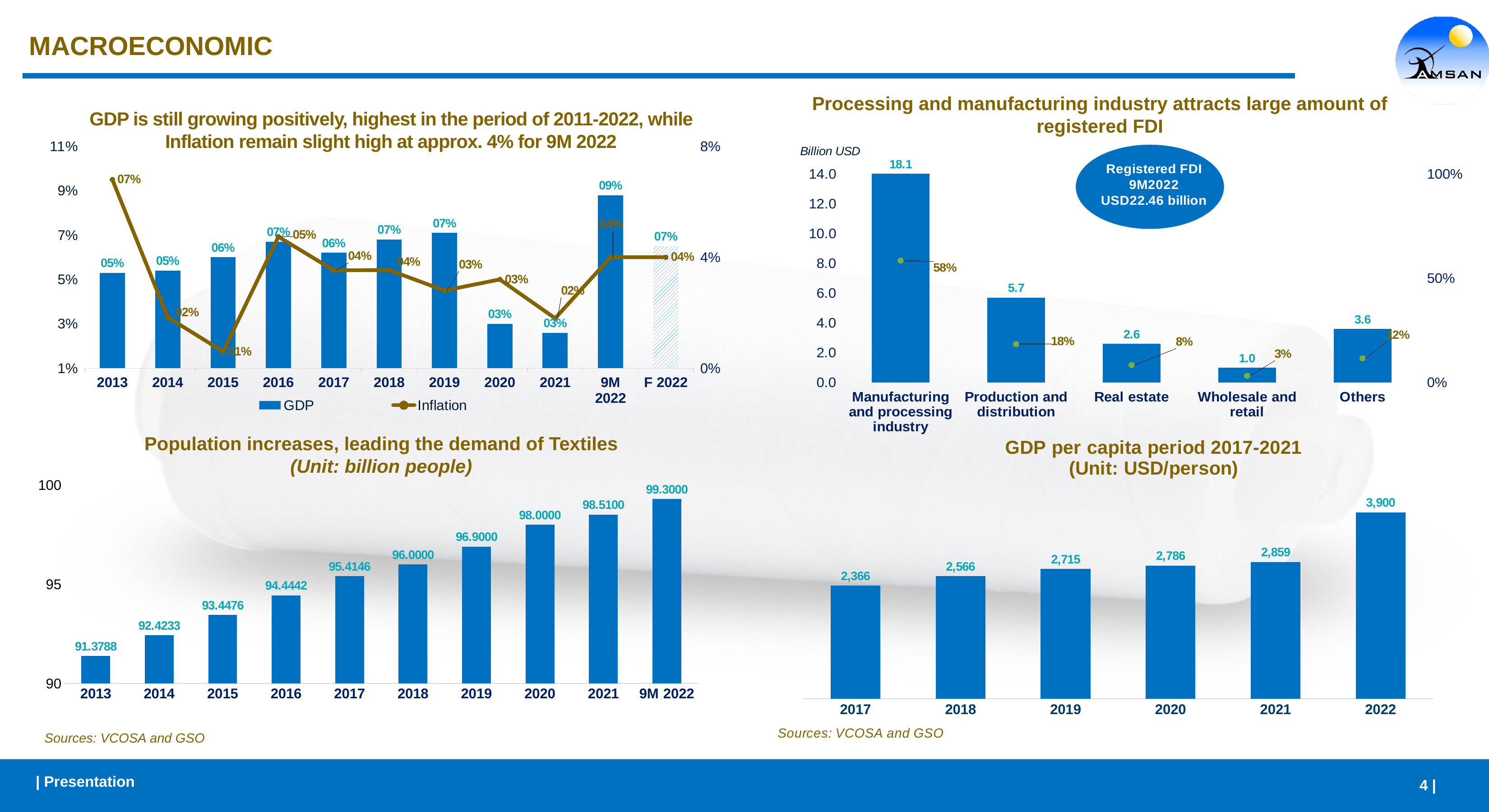
In the top-left GDP and Inflation chart, what is the GDP value for 9M 2022? 09% In the 'Population increases, leading the demand of Textiles' chart, how many bars are plotted? 10 In the 'GDP per capita period 2017-2021' chart, which year has the highest value? 2022 In the 'Population increases, leading the demand of Textiles' chart, what is the value for 2016? 94.4442 In the 'Processing and manufacturing industry attracts large amount of registered FDI' chart, which category has the lowest value? Wholesale and retail In the 'Processing and manufacturing industry attracts large amount of registered FDI' chart, what percentage share is shown for Others? 12% In the top-left GDP and Inflation chart, what is the Inflation value for 2015? 01% In the 'Population increases, leading the demand of Textiles' chart, do the values rise or fall from 2013 to 9M 2022? rise In the 'GDP per capita period 2017-2021' chart, what is the value for 2019? 2,715 In the top-left GDP and Inflation chart, how many series does the legend list? 2 In the 'Processing and manufacturing industry attracts large amount of registered FDI' chart, what is the value in billion USD for Production and distribution? 5.7 In the 'GDP per capita period 2017-2021' chart, what is the difference between the 2022 and 2021 values? 1,041